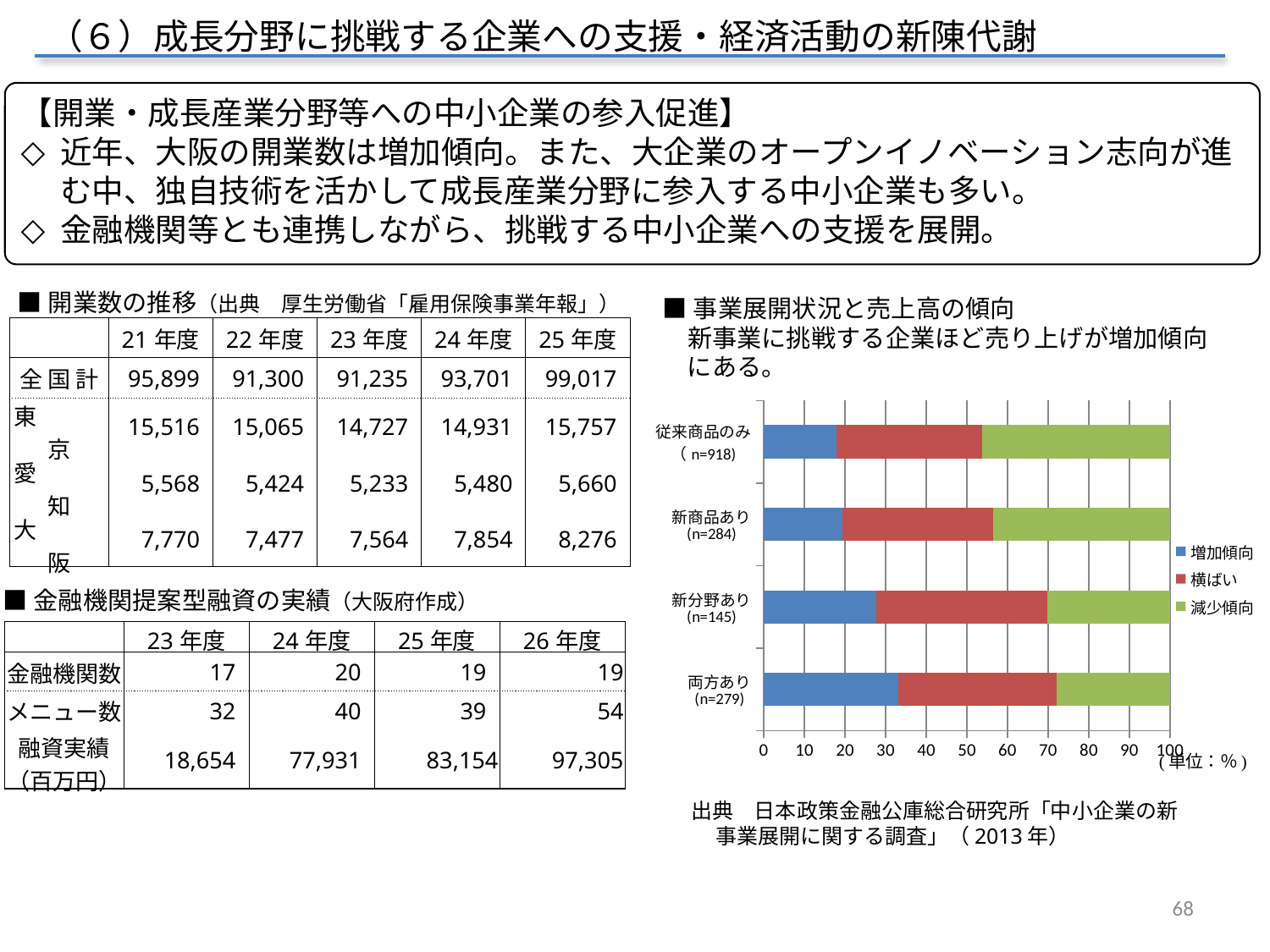
Is the 減少傾向 value for 両方あり greater or less than 40? less Which has a larger 減少傾向 share: 従来商品のみ or 新分野あり? 従来商品のみ Which colour represents 減少傾向 in the chart? Green Is the 増加傾向 value for 両方あり greater or less than 20? greater Which category has the largest 増加傾向 share? 両方あり Is the 増加傾向 value for 従来商品のみ greater or less than 30? less How many series does the chart's legend list? 3 What kind of chart is shown on the slide? Stacked horizontal bar chart How many categories (bars) does the chart show? 4 What are the three series listed in the chart's legend? 増加傾向, 横ばい, 減少傾向 Which has a larger 増加傾向 share: 両方あり or 従来商品のみ? 両方あり